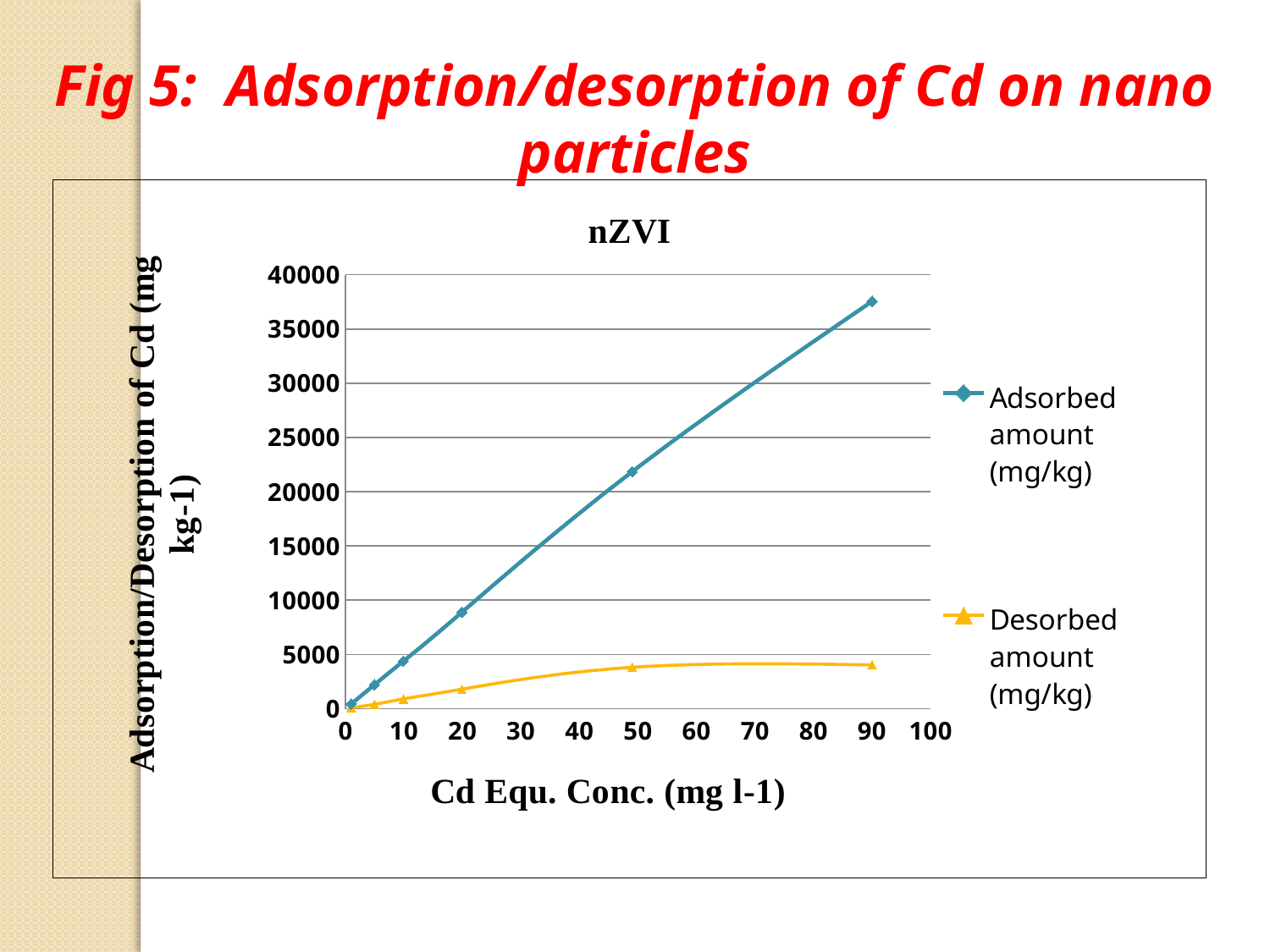
How many series does the legend list? 2 What is the x-axis title of the chart? Cd Equ. Conc. (mg l-1) At a Cd equilibrium concentration of 90, which is larger, the Adsorbed amount or the Desorbed amount? Adsorbed amount What is the title of the chart? nZVI Which series reaches the highest value on the chart, Adsorbed amount or Desorbed amount? Adsorbed amount (mg/kg) What kind of chart is shown on the slide? line chart Is the Adsorbed amount (mg/kg) at a Cd equilibrium concentration of 10 greater or less than 10000? less Is the Adsorbed amount (mg/kg) at a Cd equilibrium concentration of 90 greater or less than 35000? greater How many data points are plotted for the Adsorbed amount (mg/kg) series? 6 Does the Adsorbed amount (mg/kg) rise or fall as the Cd equilibrium concentration increases? rise Is the Adsorbed amount (mg/kg) at a Cd equilibrium concentration of 50 greater or less than 20000? greater